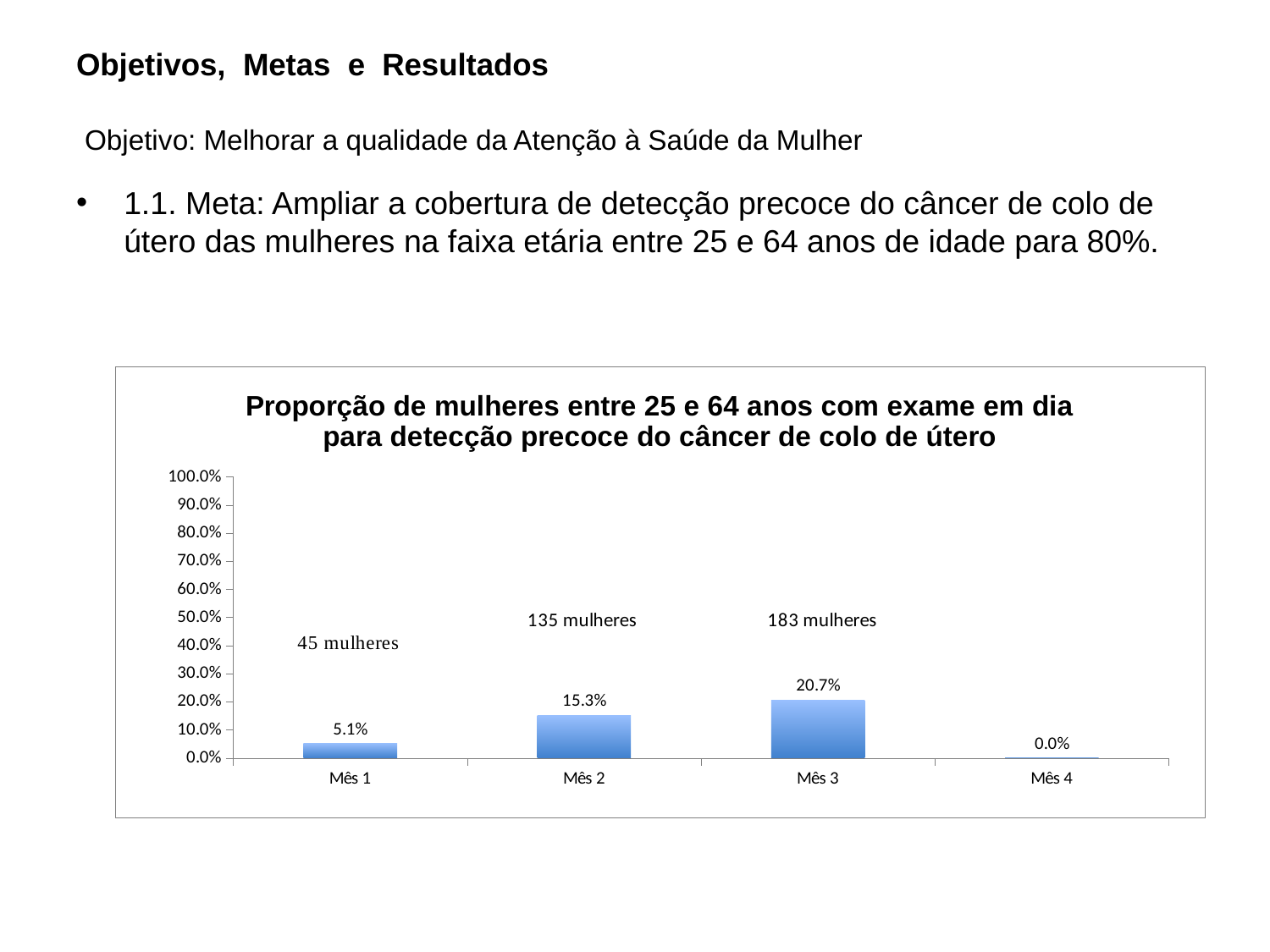
How many women are annotated above the bar for Mês 3? 183 mulheres What is the value for Mês 1? 5.1% What is the value for Mês 4? 0.0% What is the value for Mês 2? 15.3% What is the difference between the values for Mês 3 and Mês 2? 5.4% What is the highest value shown on the y axis? 100.0% Which is larger, the value for Mês 1 or the value for Mês 2? Mês 2 Which month has the lowest value? Mês 4 What kind of chart is this? Bar chart Which month has the highest value? Mês 3 What is the value for Mês 3? 20.7% How many months are shown on the x axis? 4